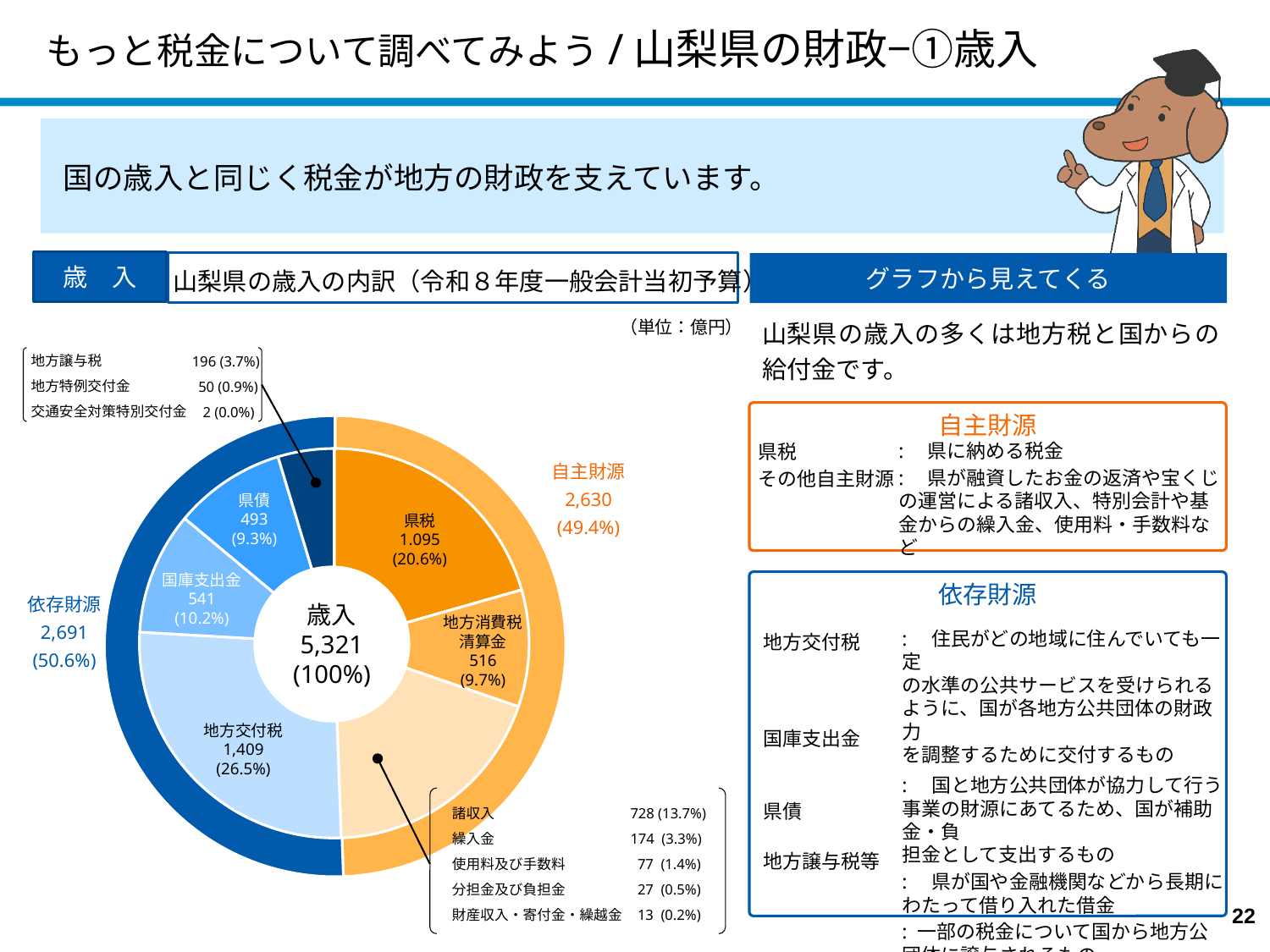
What is the value shown for 地方交付税 in the revenue chart? 1,409 What percentage share does 県税 have in the revenue chart? 20.6% What percentage share is shown for 自主財源 in the outer ring? 49.4% What is the total revenue (歳入) shown in the center of the chart? 5,321 What is the difference between the values of 地方交付税 (1,409) and 県税 (1,095)? 314 What type of chart is used to show the breakdown of Yamanashi Prefecture's revenue (山梨県の歳入の内訳)? Pie (donut) chart What is the value shown for 依存財源 in the outer ring of the chart? 2,691 Which inner-ring category has the largest value in the revenue chart? 地方交付税 What is the value shown for 地方消費税清算金 in the revenue chart? 516 In the callout for the light-orange segment, what is the value shown for 諸収入? 728 (13.7%) What unit is stated for the values in the revenue chart? 億円 Which is larger in the revenue chart, 国庫支出金 or 県債? 国庫支出金